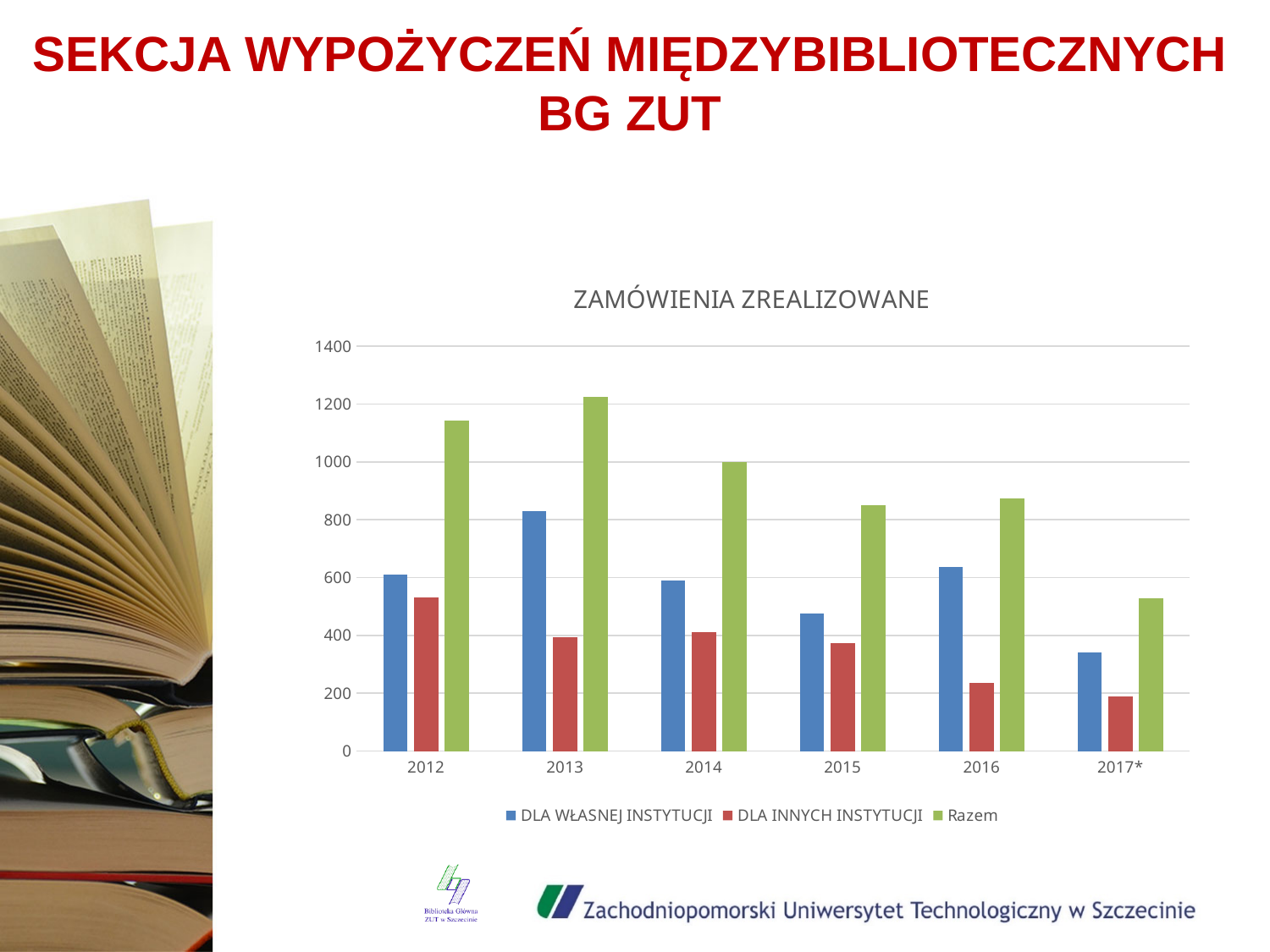
Do the DLA INNYCH INSTYTUCJI values rise or fall from 2014 to 2017*? fall In which year is the Razem value highest? 2013 How many series does the legend list? 3 Which year has the larger DLA WŁASNEJ INSTYTUCJI value, 2012 or 2013? 2013 In which year is the DLA WŁASNEJ INSTYTUCJI value highest? 2013 In which year is the Razem value lowest? 2017* How many years are shown on the x axis? 6 What is the title of the chart? ZAMÓWIENIA ZREALIZOWANE What kind of chart is shown on the slide? bar chart Is the DLA INNYCH INSTYTUCJI value for 2016 greater or less than 400? less Is the Razem value for 2012 greater or less than 1000? greater In which year is the DLA INNYCH INSTYTUCJI value lowest? 2017*